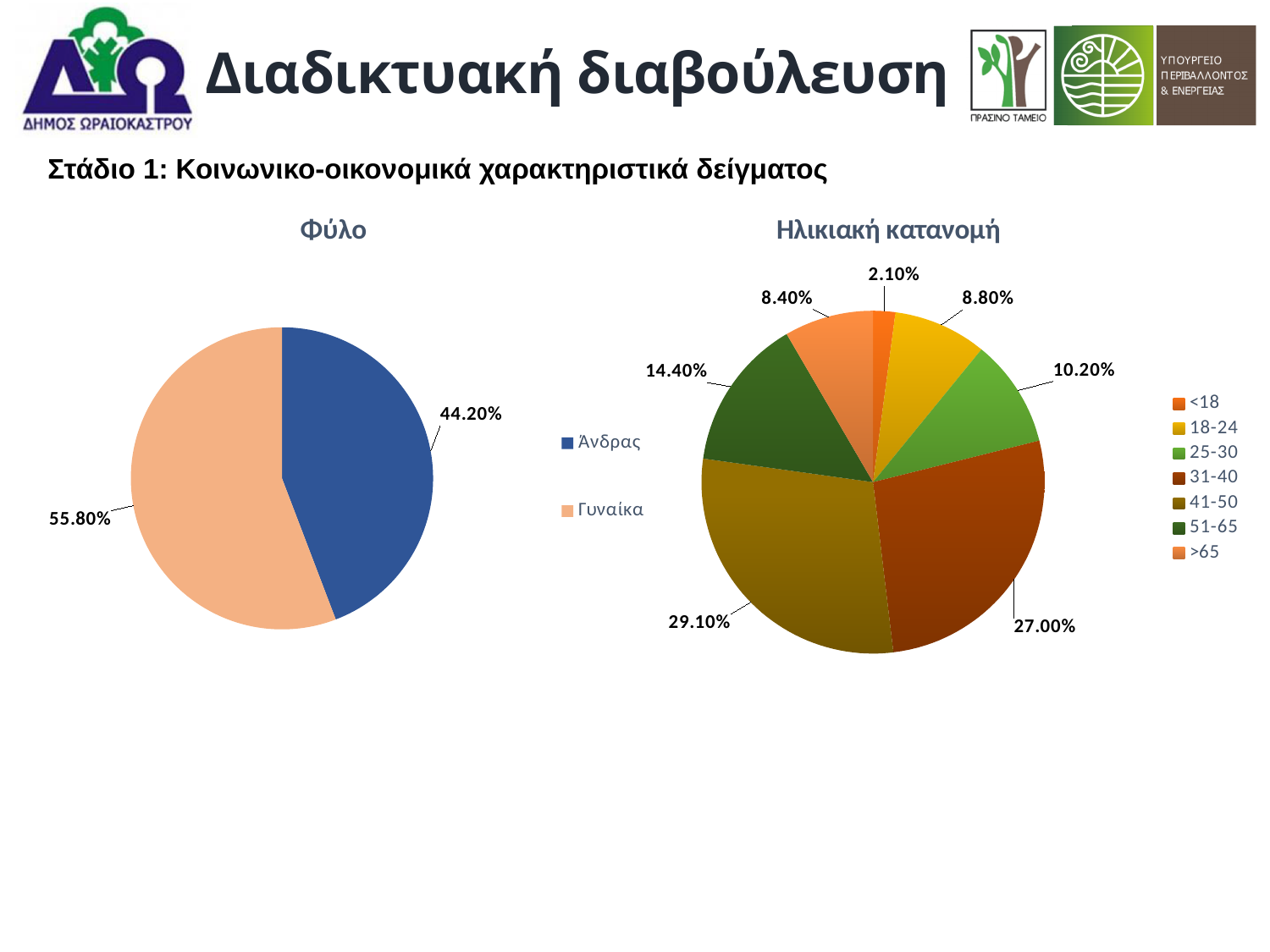
In the Ηλικιακή κατανομή chart, which is larger, the share for 18-24 or the share for >65? 18-24 In the Ηλικιακή κατανομή chart, which age group has the largest share? 41-50 In the Ηλικιακή κατανομή chart, what is the value for 51-65? 14.40% In the Ηλικιακή κατανομή chart, how many age groups are shown? 7 In the Φύλο chart, which category has the larger share? Γυναίκα In the Φύλο chart, what is the value for Γυναίκα? 55.80% In the Ηλικιακή κατανομή chart, which age group has the smallest share? <18 In the Φύλο chart, what is the difference between the Γυναίκα and Άνδρας shares? 11.60% What kind of chart is the Φύλο chart? Pie chart In the Φύλο chart, what is the value for Άνδρας? 44.20% In the Ηλικιακή κατανομή chart, what is the difference between the 41-50 and 25-30 shares? 18.90% In the Ηλικιακή κατανομή chart, what is the value for 31-40? 27.00%